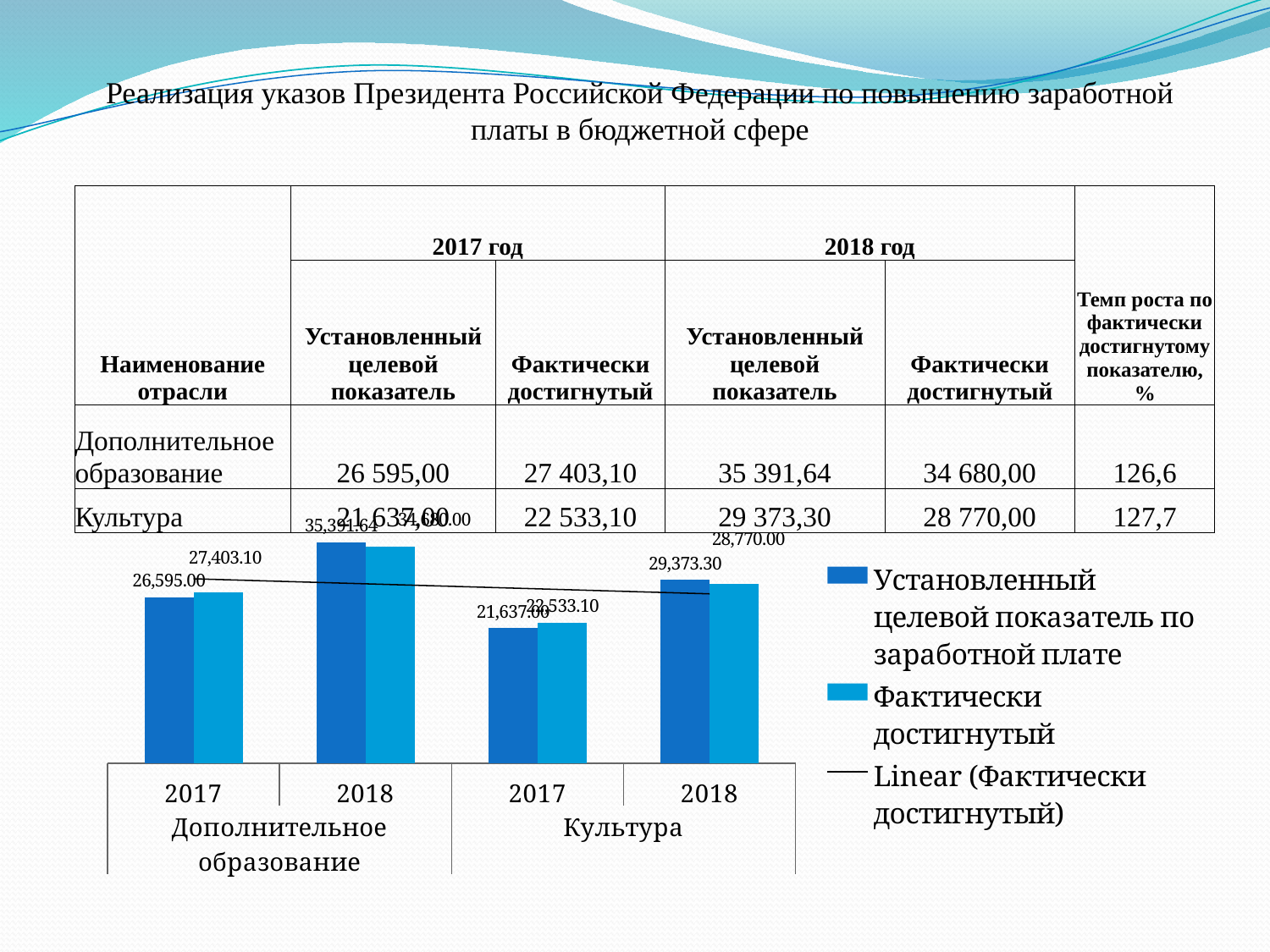
What is the value of Фактически достигнутый for Культура in 2017? 22,533.10 For Культура in 2018, which is larger: Установленный целевой показатель or Фактически достигнутый? Установленный целевой показатель How many entries does the chart legend list? 3 What is the third entry in the chart legend? Linear (Фактически достигнутый) What is the value of Фактически достигнутый for Дополнительное образование in 2017? 27,403.10 What is the value of Установленный целевой показатель по заработной плате for Культура in 2018? 29,373.30 What is the value of Установленный целевой показатель по заработной плате for Дополнительное образование in 2017? 26,595.00 What is the value of Фактически достигнутый for Культура in 2018? 28,770.00 What kind of chart is shown on the slide? bar chart What is the difference between Фактически достигнутый and Установленный целевой показатель for Дополнительное образование in 2017? 808.10 How many year categories are shown along the x axis of the chart? 4 What is the difference between Установленный целевой показатель and Фактически достигнутый for Культура in 2018? 603.30